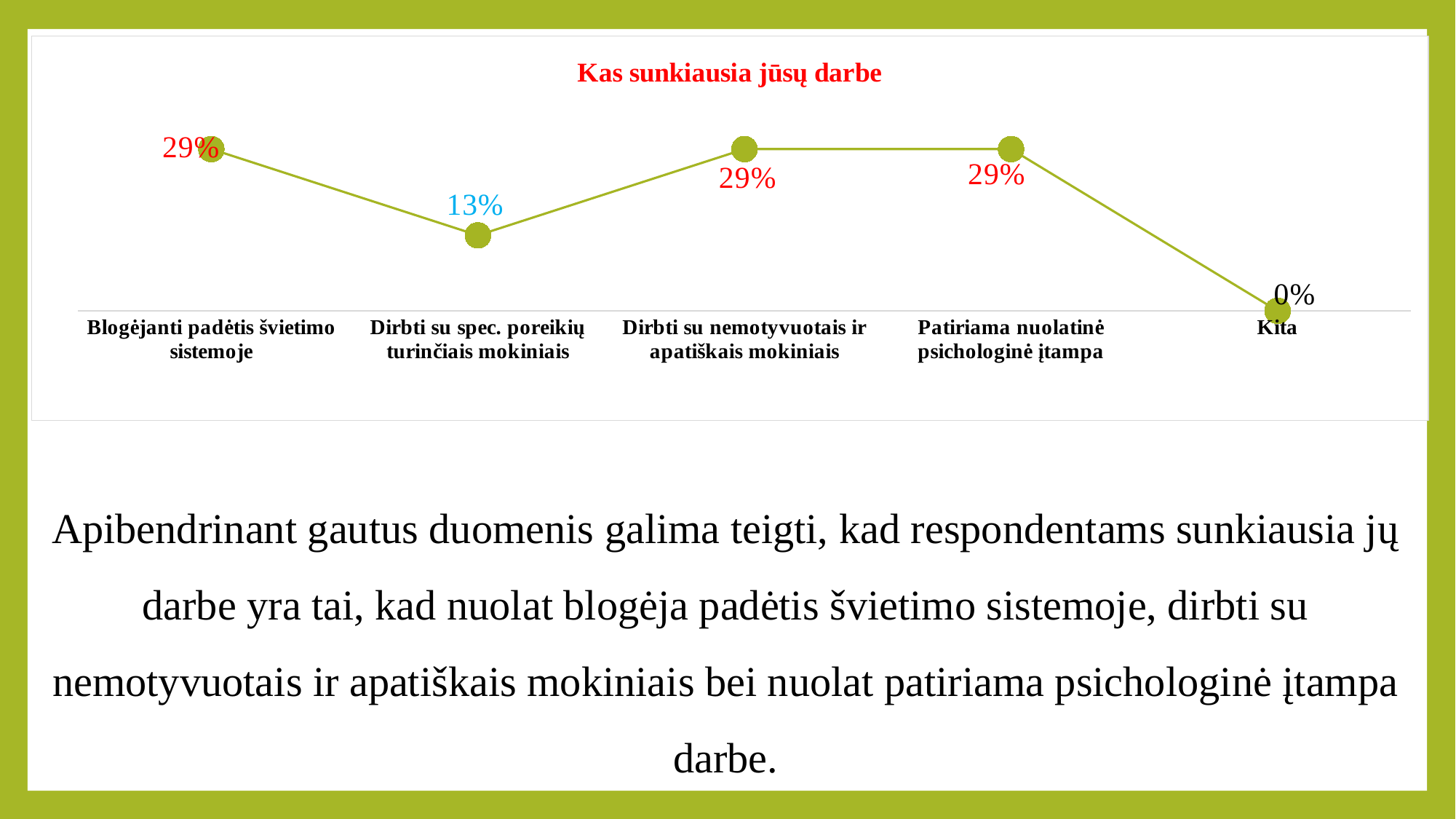
Does the value rise or fall from "Patiriama nuolatinė psichologinė įtampa" to "Kita"? Fall Which is larger, the value for "Dirbti su nemotyvuotais ir apatiškais mokiniais" or the value for "Dirbti su spec. poreikių turinčiais mokiniais"? Dirbti su nemotyvuotais ir apatiškais mokiniais What is the difference between the values for "Dirbti su spec. poreikių turinčiais mokiniais" and "Kita"? 13% What is the value for "Dirbti su spec. poreikių turinčiais mokiniais"? 13% What is the value for "Blogėjanti padėtis švietimo sistemoje"? 29% How many categories are shown on the x axis? 5 What is the difference between the values for "Blogėjanti padėtis švietimo sistemoje" and "Dirbti su spec. poreikių turinčiais mokiniais"? 16% What kind of chart is this? Line chart What is the value for "Kita"? 0% What is the title of the chart? Kas sunkiausia jūsų darbe Which category has the lowest value? Kita What is the value for "Patiriama nuolatinė psichologinė įtampa"? 29%